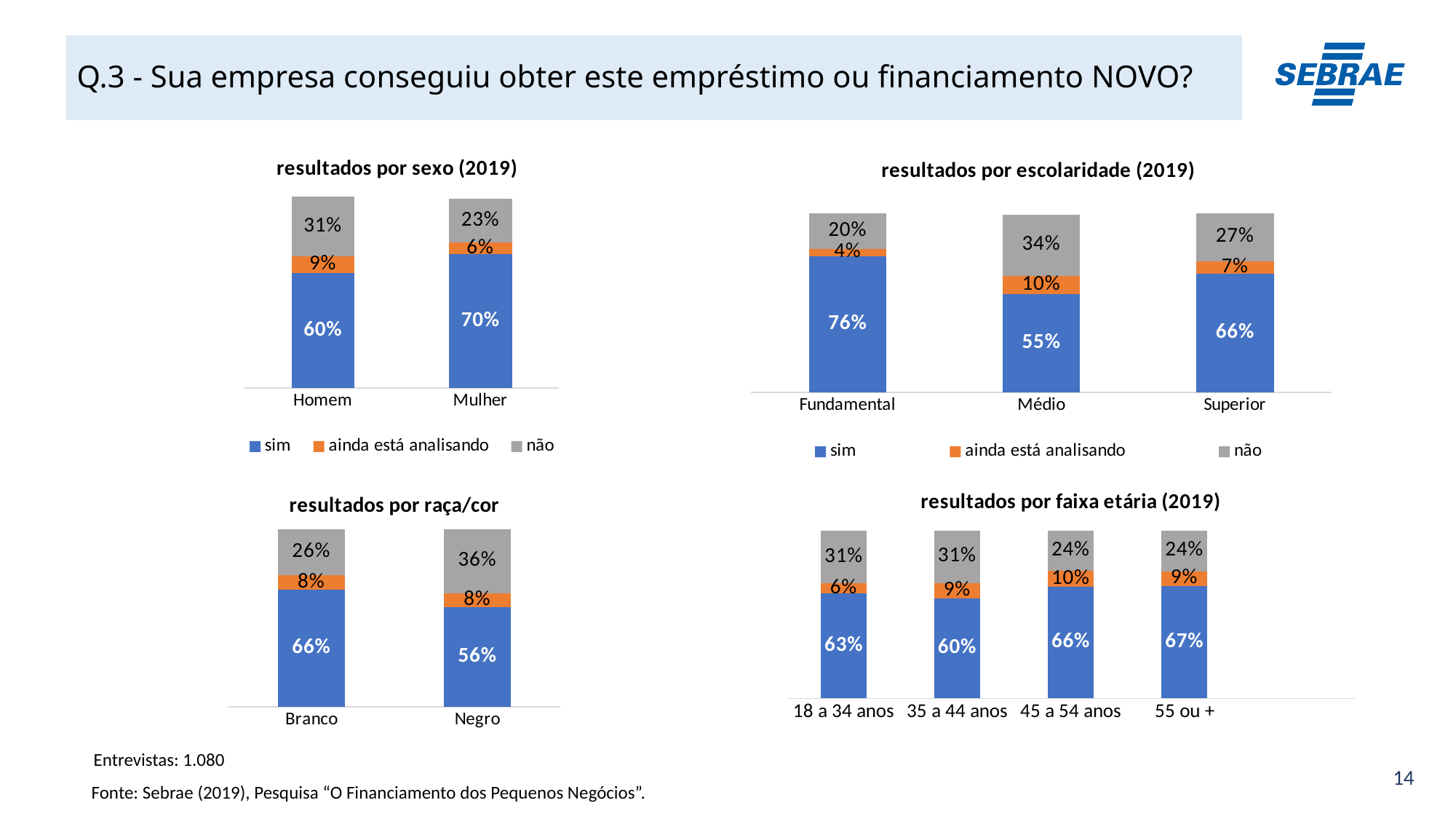
In the chart 'resultados por faixa etária (2019)', what is the 'sim' value for 55 ou +? 67% In the chart 'resultados por escolaridade (2019)', which category has the lowest 'sim' value? Médio In the chart 'resultados por sexo (2019)', what is the value of 'não' for Homem? 31% In the chart 'resultados por raça/cor', which is larger, the 'sim' value for Branco or for Negro? Branco In the chart 'resultados por sexo (2019)', what is the value of 'sim' for Mulher? 70% In the chart 'resultados por faixa etária (2019)', what is the difference between the 'sim' values for 45 a 54 anos and 35 a 44 anos? 6% In the chart 'resultados por sexo (2019)', what is the total of the stacked bar for Homem? 100% How many series does the legend of the chart 'resultados por sexo (2019)' list? 3 In the chart 'resultados por faixa etária (2019)', how many age categories are shown? 4 In the chart 'resultados por raça/cor', what is the 'ainda está analisando' value for Negro? 8% In the chart 'resultados por escolaridade (2019)', what is the difference between the 'não' values for Médio and Fundamental? 14% In the chart 'resultados por escolaridade (2019)', which category has the highest 'sim' value? Fundamental